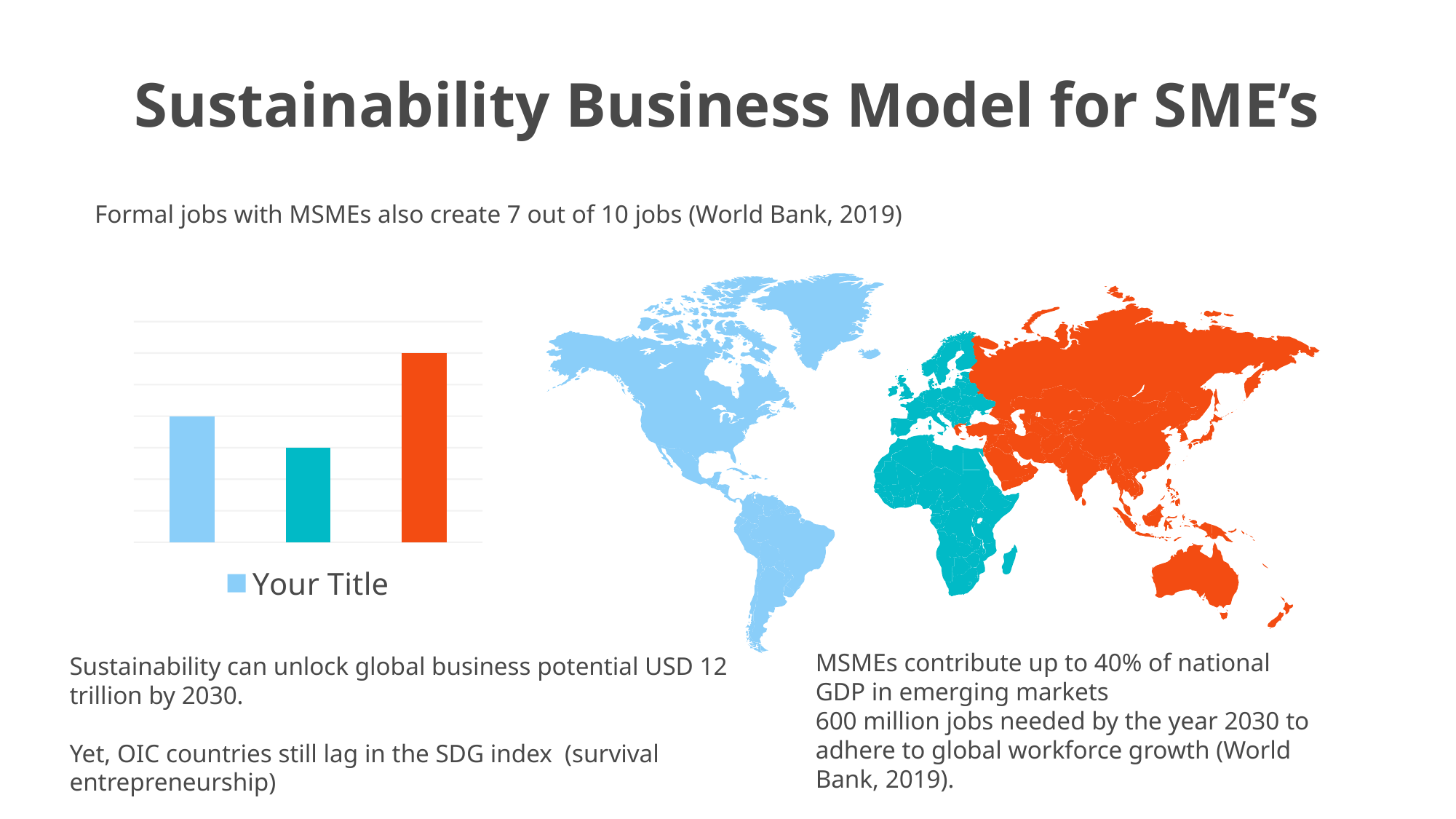
What kind of chart is shown on the left of the slide? bar chart Are the bars in the bar chart vertical or horizontal? vertical Which bar in the bar chart is the tallest: the first (light blue), the second (teal) or the third (orange)? the third (orange) In the bar chart, is the first (light blue) bar taller or shorter than the second (teal) bar? taller What text does the legend of the bar chart show? Your Title How many bars does the bar chart on the left of the slide have? 3 How many entries does the legend of the bar chart list? 1 In the bar chart, is the orange bar taller or shorter than the light blue bar? taller Which bar in the bar chart is the shortest: the first (light blue), the second (teal) or the third (orange)? the second (teal) What colour is the tallest bar in the bar chart? orange